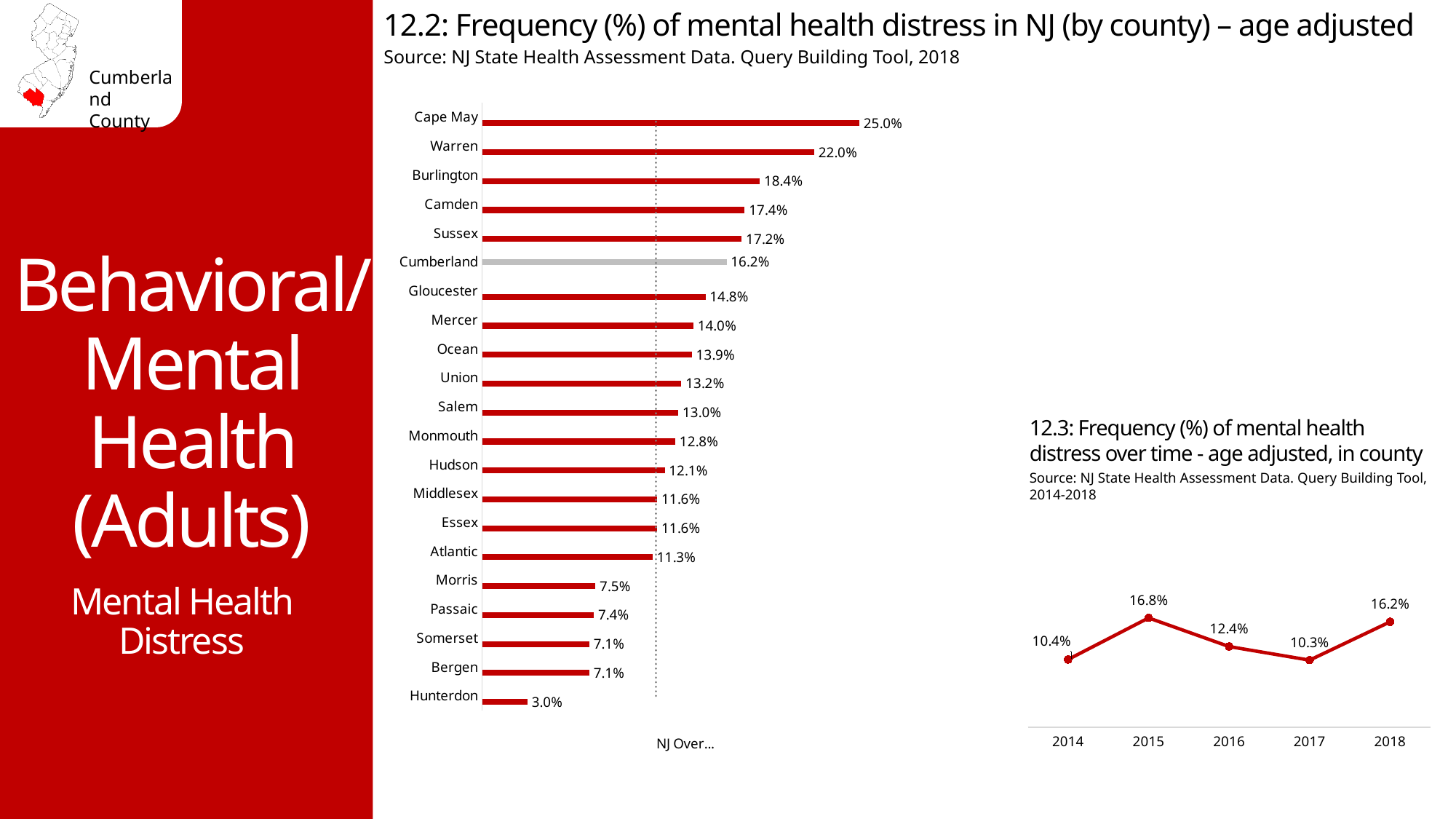
In chart 12.2 (frequency of mental health distress by county), which is larger, the value for Camden or the value for Gloucester? Camden In chart 12.2 (frequency of mental health distress by county), what is the difference between Cape May and Warren? 3.0% What kind of chart is chart 12.2 (frequency of mental health distress by county)? Bar chart In chart 12.2 (frequency of mental health distress by county), which county has the lowest value? Hunterdon In chart 12.2 (frequency of mental health distress by county), how many counties are shown? 21 In chart 12.3 (frequency of mental health distress over time), which year has the lowest value? 2017 In chart 12.3 (frequency of mental health distress over time), what is the difference between the 2018 value and the 2014 value? 5.8% In chart 12.2 (frequency of mental health distress by county), what is the value for Cumberland? 16.2% In chart 12.3 (frequency of mental health distress over time), what is the value for 2015? 16.8% What kind of chart is chart 12.3 (frequency of mental health distress over time)? Line chart In chart 12.2 (frequency of mental health distress by county), which county has the highest value? Cape May In chart 12.2 (frequency of mental health distress by county), what is the value for Morris? 7.5%